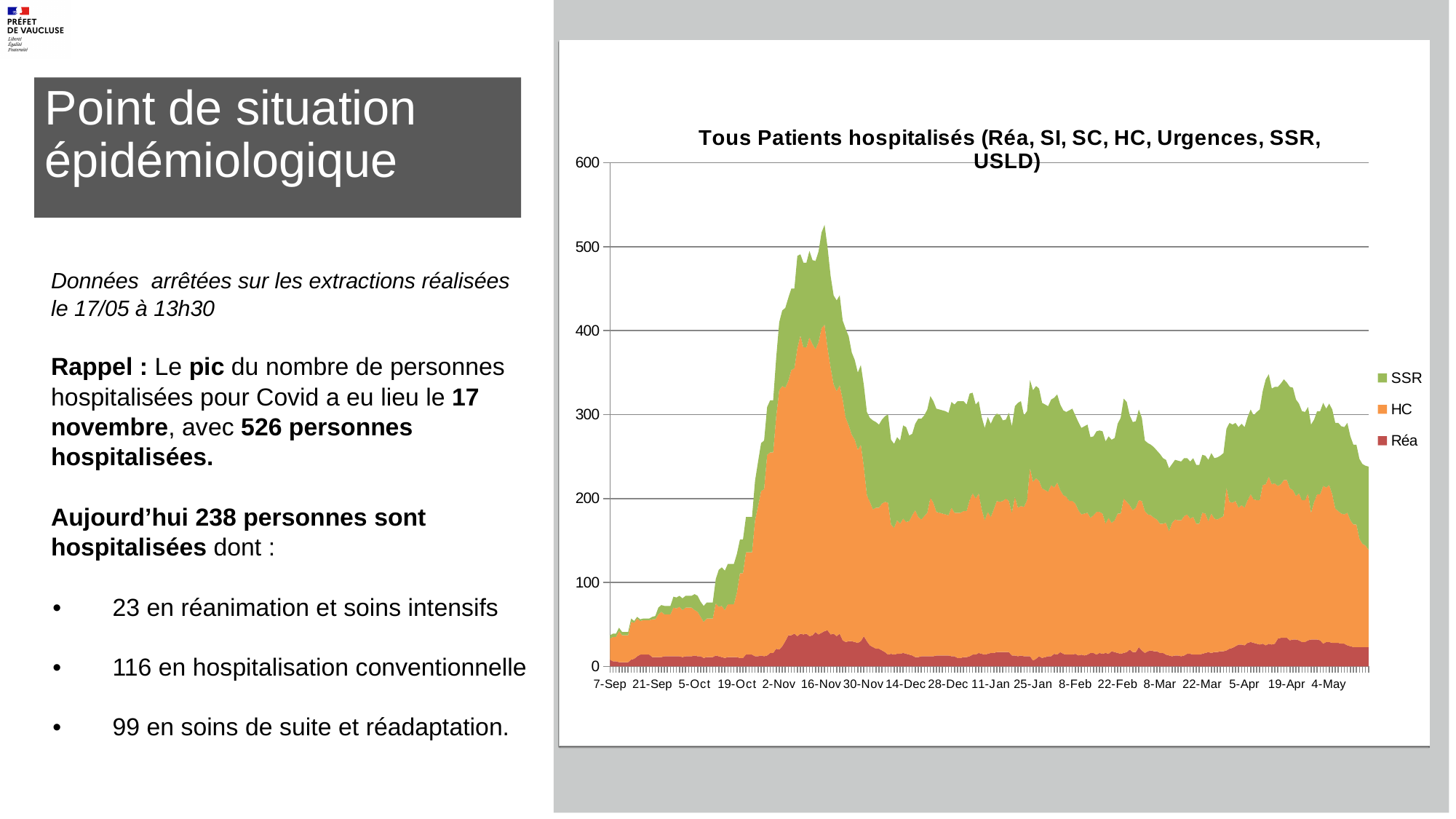
Does the total number of hospitalised patients rise or fall between 7-Sep and 16-Nov? rise Is the Réa series ever greater or less than 100 over the whole period? less How many date labels are shown on the x axis of the chart? 18 What is the title of the chart? Tous Patients hospitalisés (Réa, SI, SC, HC, Urgences, SSR, USLD) How many series does the legend of the chart list? 3 Is the total of hospitalised patients at 7-Sep greater or less than 100? less What are the three series listed in the chart legend? SSR, HC, Réa Is the total of hospitalised patients at 19-Apr greater or less than 300? greater Does the total number of hospitalised patients rise or fall between 16-Nov and 14-Dec? fall What kind of chart is shown on the slide? area chart At the mid-November peak, which series is larger, HC or Réa? HC